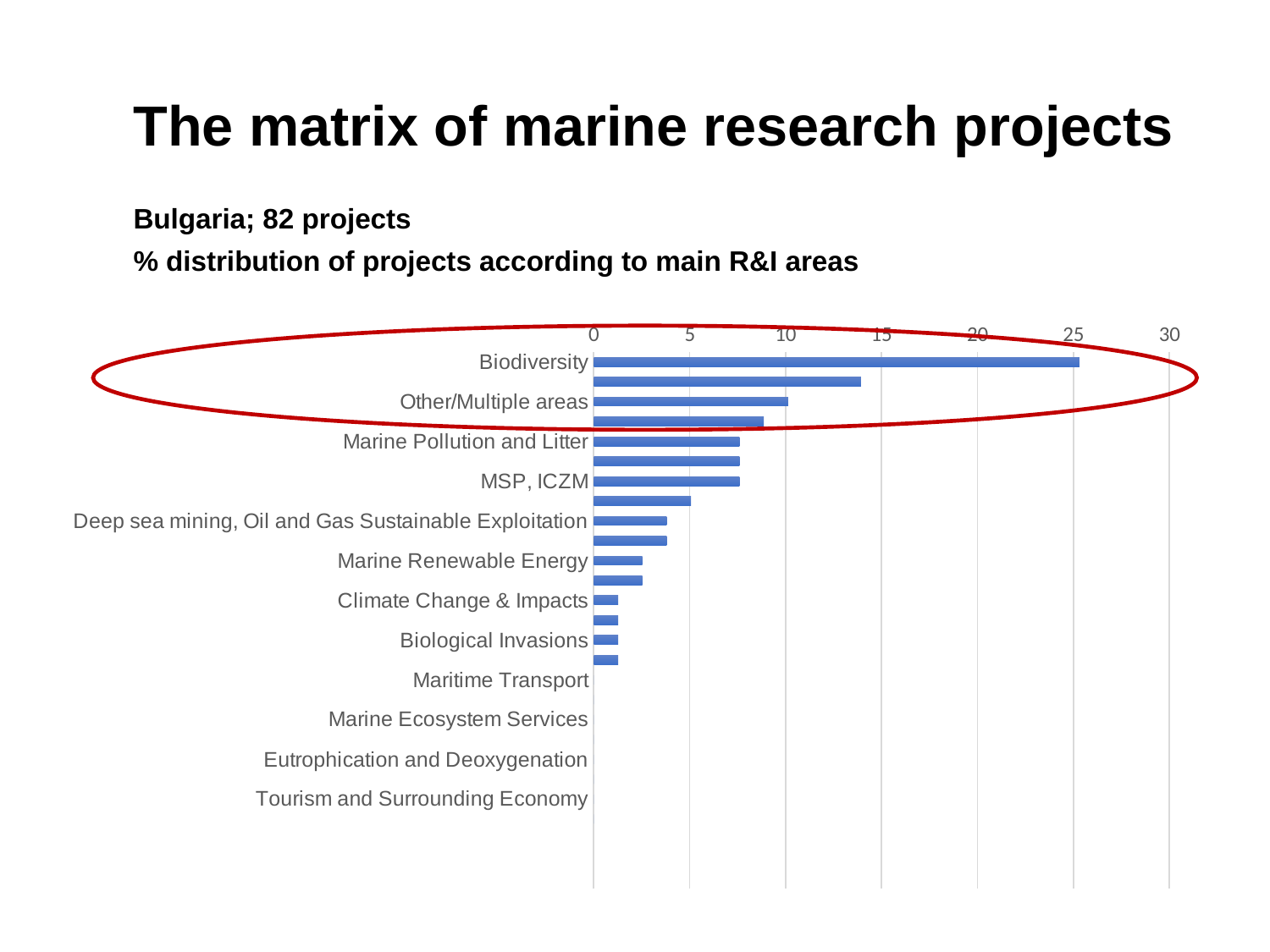
Is the value for Other/Multiple areas greater or less than 5? greater Is the value for Other/Multiple areas greater or less than 15? less Do the bar lengths increase or decrease going from the top of the chart to the bottom? decrease Which is larger, the value for Biodiversity or the value for Other/Multiple areas? Biodiversity Is the value for Deep sea mining, Oil and Gas Sustainable Exploitation greater or less than 5? less Which R&I area has the highest percentage of projects? Biodiversity What kind of chart is shown on the slide? bar chart Which country and how many projects does the chart describe, according to the text above it? Bulgaria; 82 projects Which is larger, the value for Marine Renewable Energy or the value for Climate Change & Impacts? Marine Renewable Energy